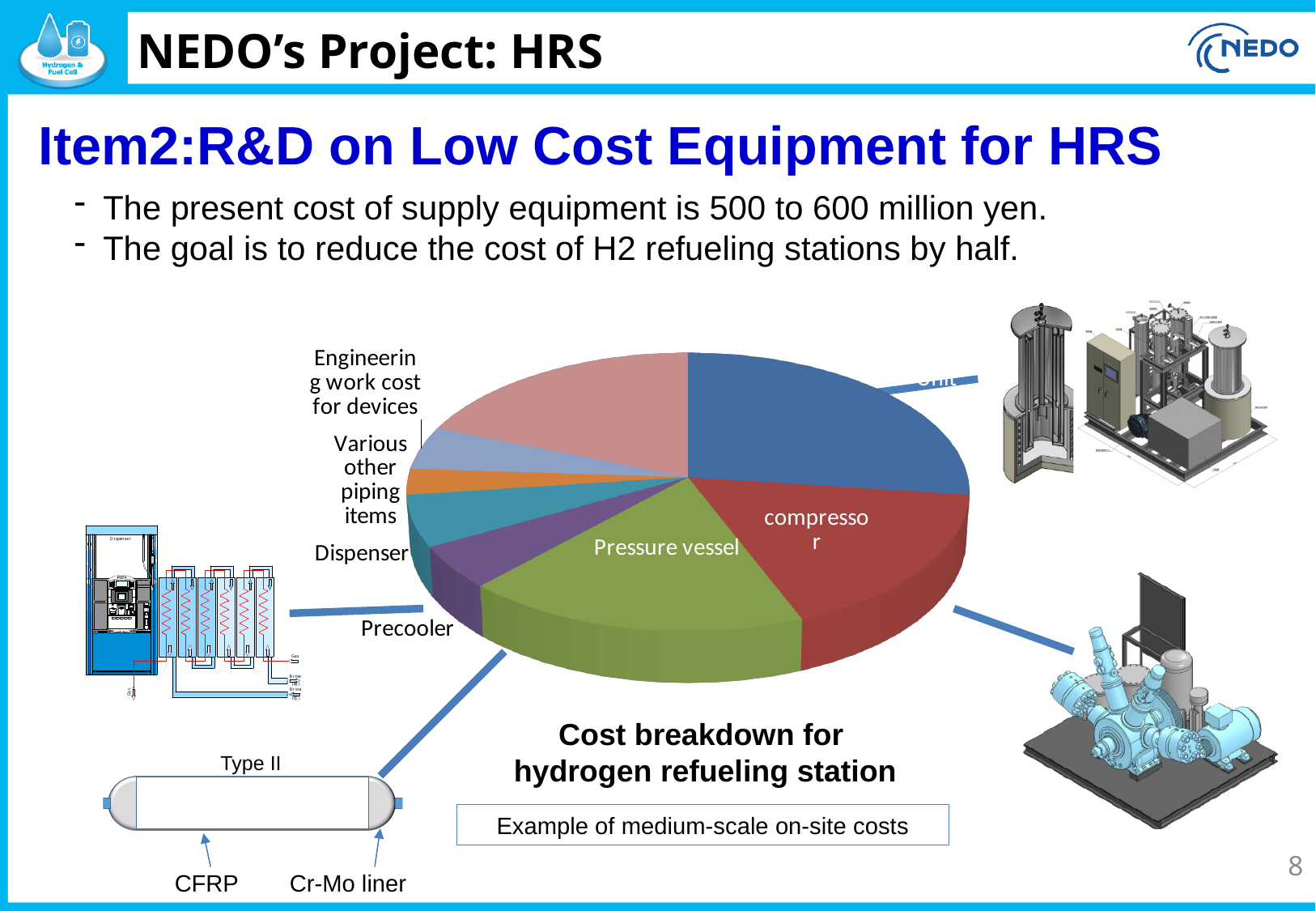
In the cost breakdown pie chart, which slice is larger: Dispenser or Various other piping items? Dispenser What is the title of the pie chart? Cost breakdown for hydrogen refueling station In the cost breakdown pie chart, which slice is larger: Precooler or Various other piping items? Precooler In the cost breakdown pie chart, which slice is larger: Pressure vessel or Dispenser? Pressure vessel What kind of chart is used to show the cost breakdown for the hydrogen refueling station? pie chart According to the caption below the pie chart, what example do the costs represent? Example of medium-scale on-site costs How many slices does the cost breakdown pie chart have? 8